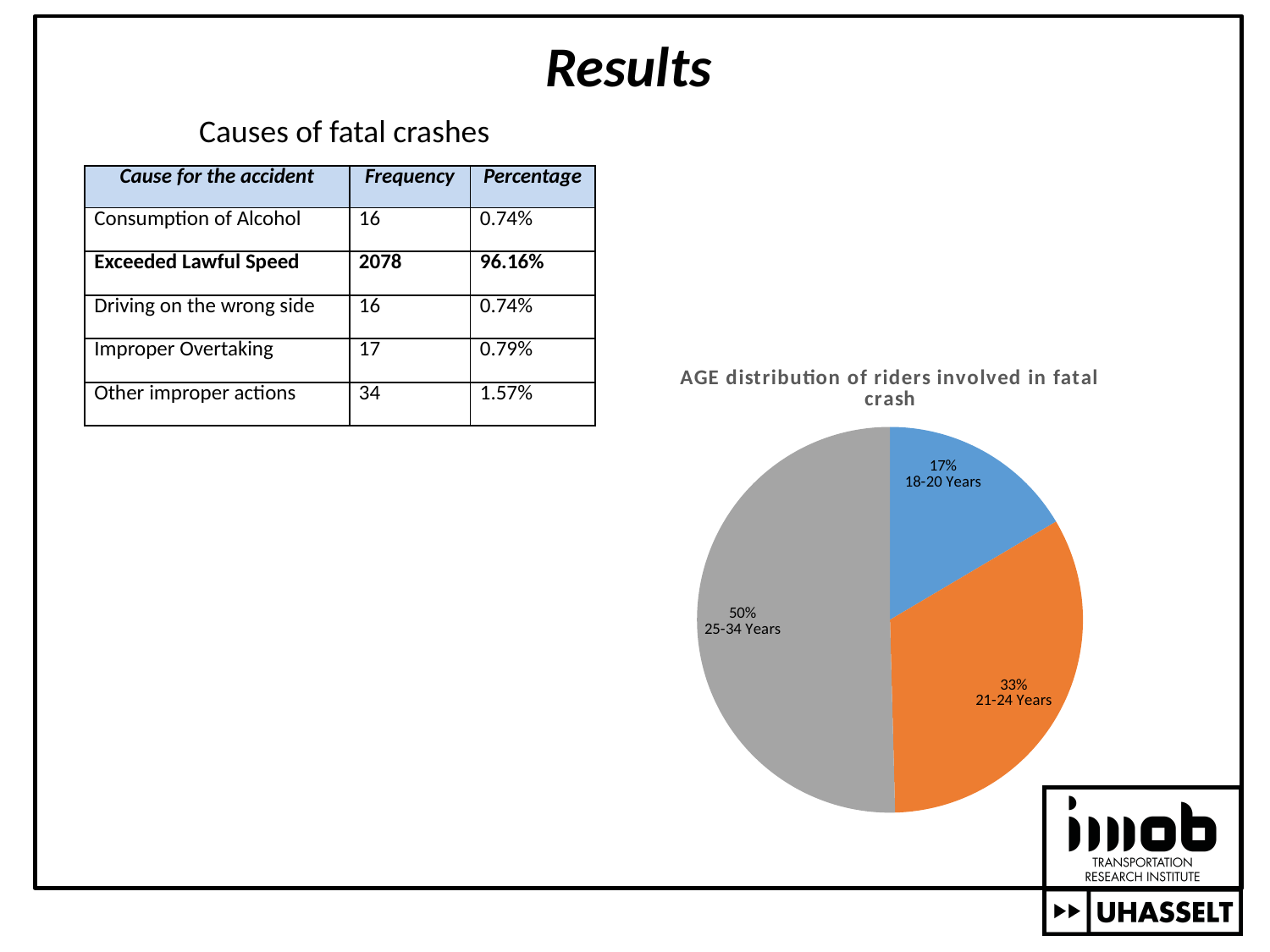
Which age group has the smallest slice of the pie? 18-20 Years What is the difference in percentage points between the 21-24 Years slice and the 18-20 Years slice? 16 What share of the pie does the 25-34 Years slice represent? 50% Which age group has the largest slice of the pie? 25-34 Years What share of the pie does the 18-20 Years slice represent? 17% What is the difference in percentage points between the 25-34 Years slice and the 18-20 Years slice? 33 What share of the pie does the 21-24 Years slice represent? 33% How many age groups are shown in the pie chart? 3 What is the title of the chart on the slide? AGE distribution of riders involved in fatal crash Which slice is larger, 21-24 Years or 18-20 Years? 21-24 Years What colour is the 25-34 Years slice in the pie chart? grey What type of chart is used to show the age distribution of riders involved in fatal crashes? pie chart